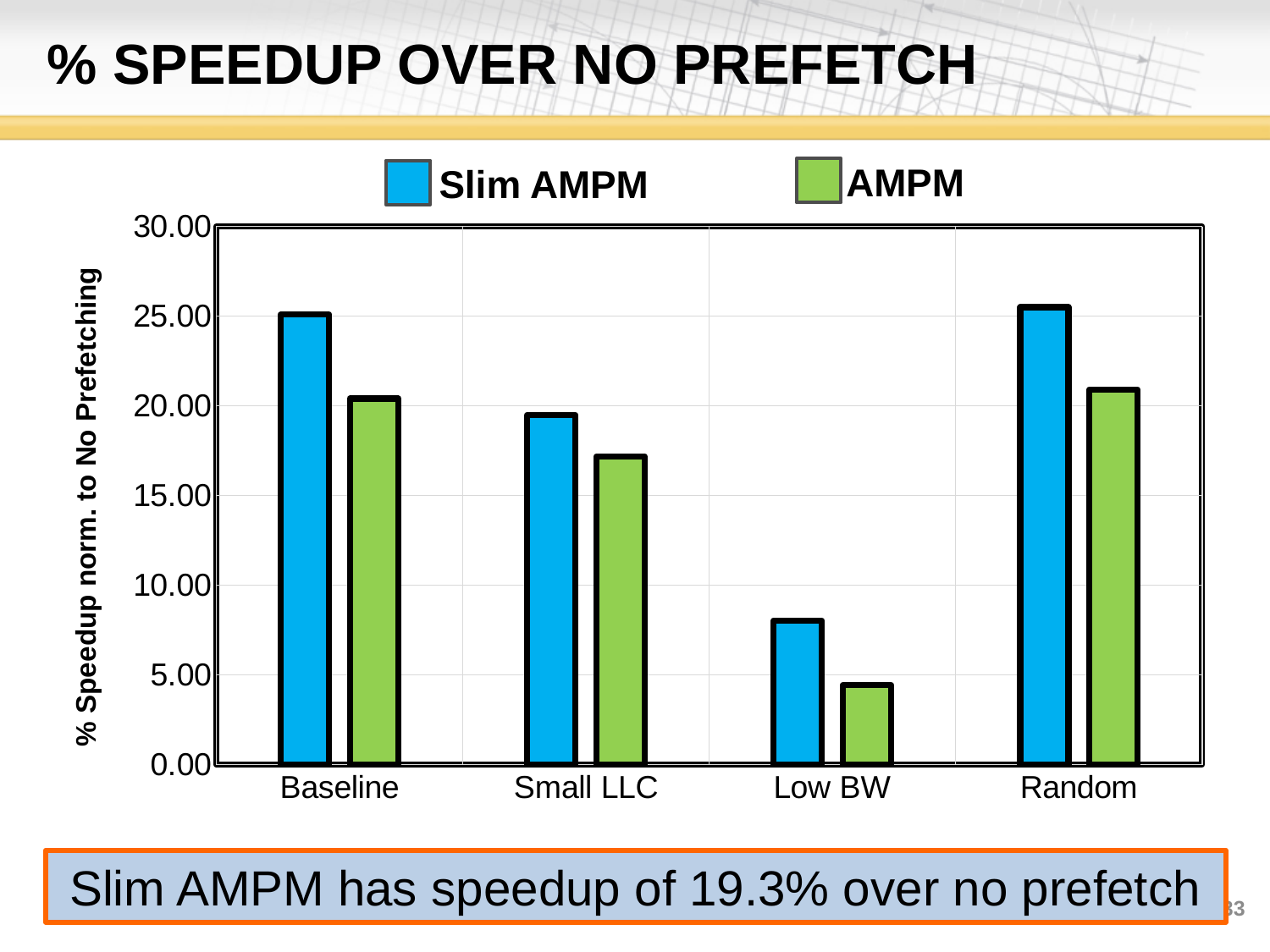
Which category has the lowest Slim AMPM value? Low BW For Low BW, which is larger: the Slim AMPM value or the AMPM value? Slim AMPM Which category has the lowest AMPM value? Low BW What kind of chart is shown on the slide? bar chart How many categories are shown on the x axis? 4 Is the AMPM value for Small LLC greater or less than 15.00? greater For Baseline, which is larger: the Slim AMPM value or the AMPM value? Slim AMPM Is the Slim AMPM value for Baseline greater or less than 20.00? greater Is the Slim AMPM value for Low BW greater or less than 10.00? less What is the label of the y axis? % Speedup norm. to No Prefetching How many series does the legend list? 2